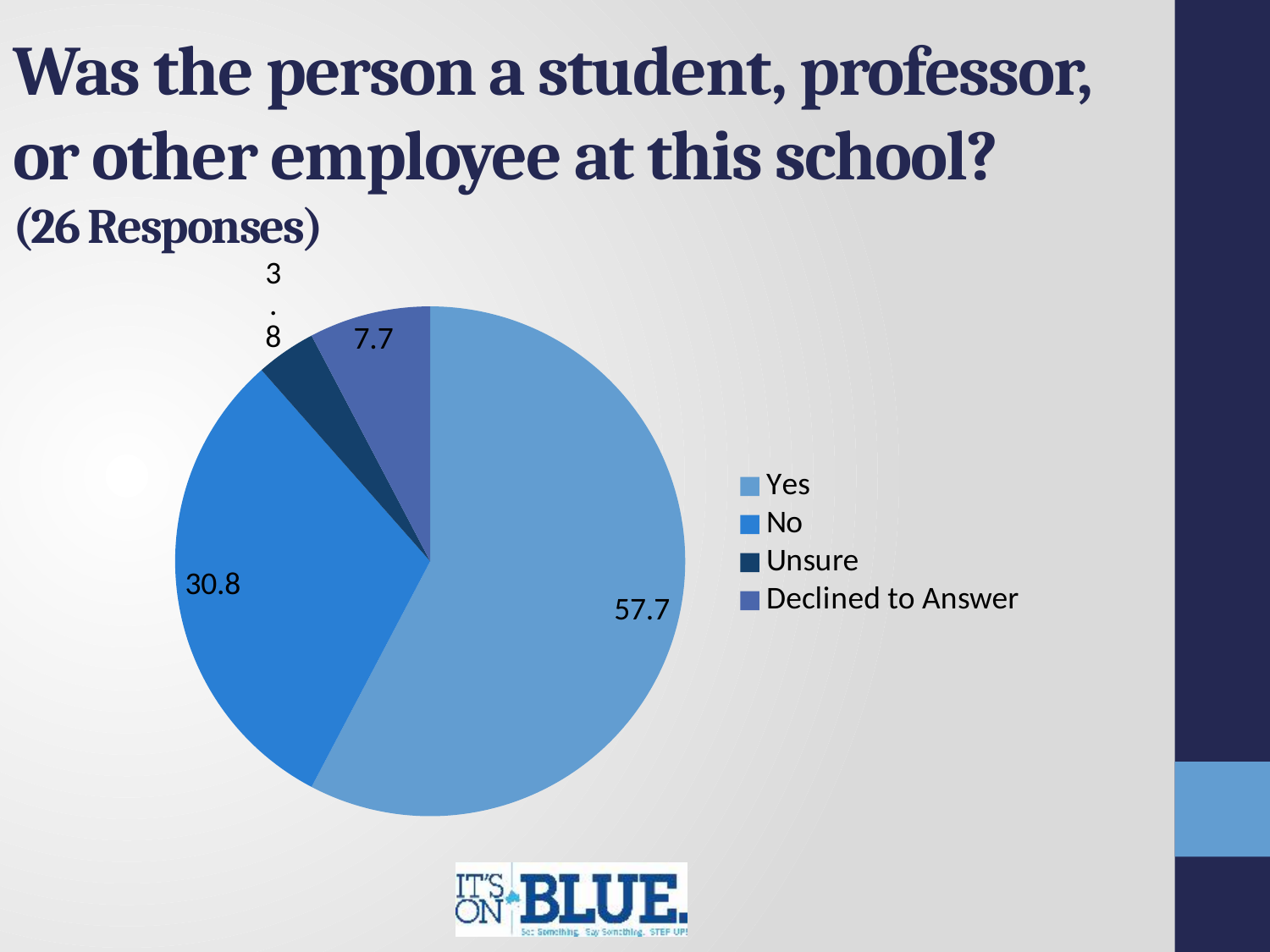
Which category has the largest slice of the pie? Yes What is the value shown for the Declined to Answer slice? 7.7 What kind of chart is shown on the slide? pie chart Which category has the smallest slice of the pie? Unsure How many entries does the legend list? 4 What is the difference between the Yes value and the No value? 26.9 How many categories does the pie chart have? 4 What is the value shown for the Unsure slice? 3.8 What is the value shown for the No slice? 30.8 What is the value shown for the Yes slice? 57.7 Which is larger, the Declined to Answer slice or the Unsure slice? Declined to Answer How many responses does the slide say the chart is based on? 26 Responses